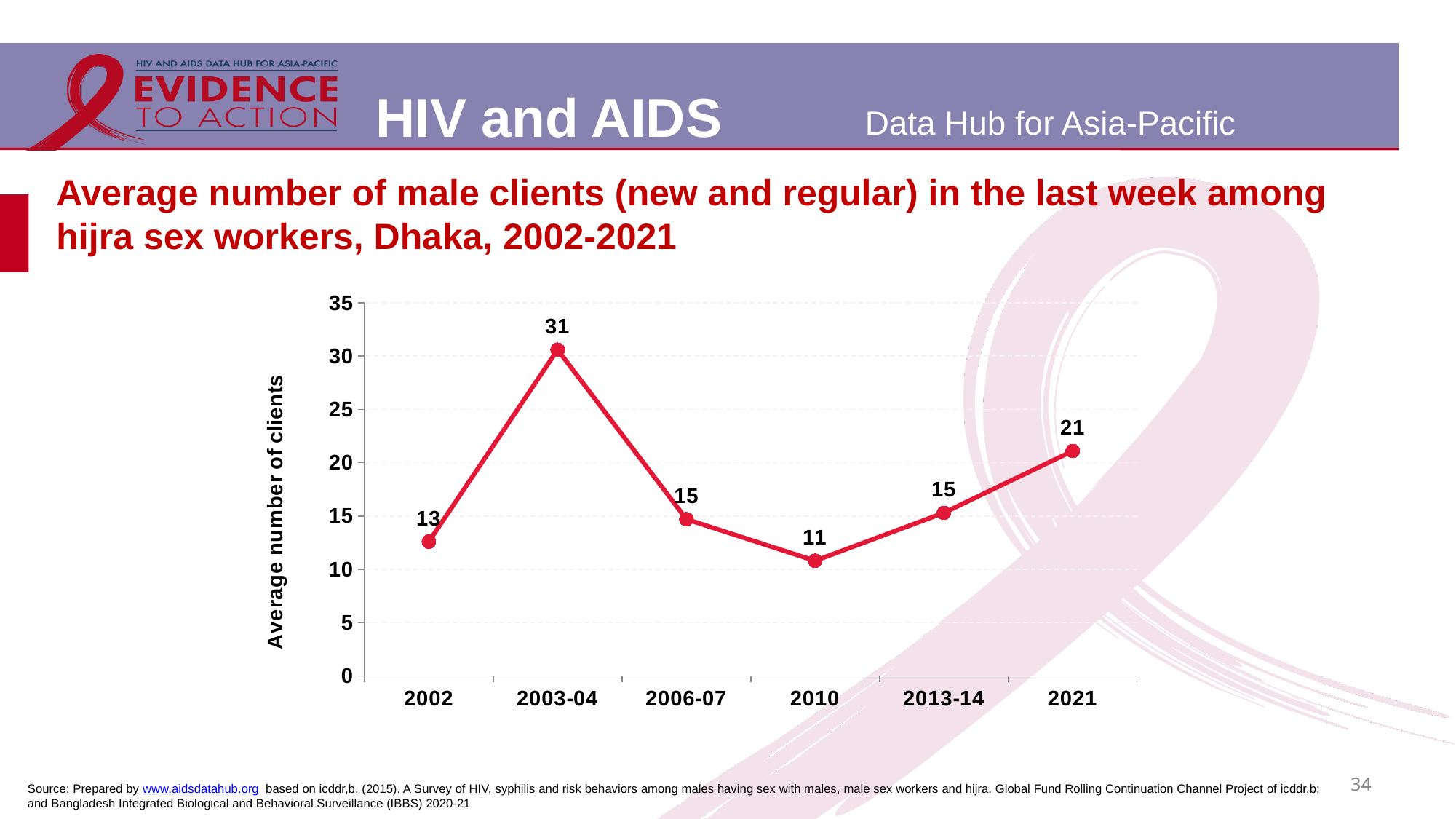
Which survey period has the lowest average number of clients? 2010 How many survey periods are plotted on the x axis? 6 What is the average number of male clients in the last week among hijra sex workers in Dhaka in 2002? 13 What is the label of the vertical axis? Average number of clients Is the value for 2006-07 greater or less than 20? less What is the difference between the average number of clients in 2003-04 and in 2010? 20 Which survey period has the highest average number of clients? 2003-04 Which is larger, the average number of clients in 2002 or in 2021? 2021 What kind of chart is shown on the slide? line chart By how much did the average number of clients increase from 2013-14 to 2021? 6 What is the average number of clients shown for 2021? 21 What is the average number of clients shown for 2003-04? 31